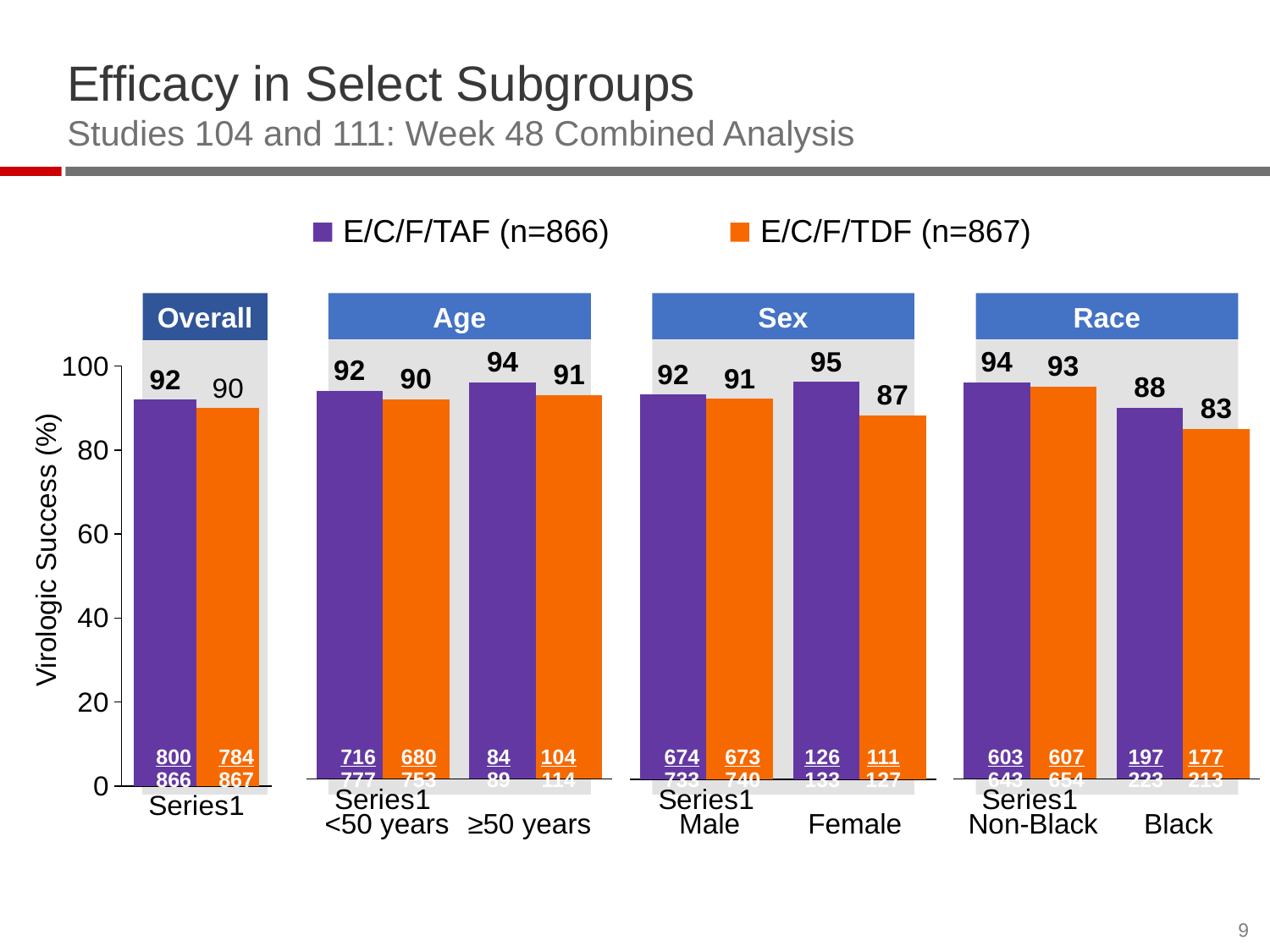
In the Overall chart, what is the virologic success value for E/C/F/TDF? 90 In the Race chart, what is the value for E/C/F/TDF in the Black group? 83 In the Age chart, which group has the higher E/C/F/TAF value, <50 years or ≥50 years? ≥50 years In the Race chart, what is the difference between the E/C/F/TAF and E/C/F/TDF values for the Black group? 5 In the Age chart, what is the value for E/C/F/TDF in the ≥50 years group? 91 In the Overall chart, what is the virologic success value for E/C/F/TAF? 92 What kind of chart is used on this slide? Bar chart In the Race chart, which group has the lowest E/C/F/TDF value? Black In the Sex chart, what is the value for E/C/F/TAF in the Female group? 95 How many series does the legend list? 2 In the Sex chart, what is the difference between the E/C/F/TAF and E/C/F/TDF values for the Female group? 8 What is the label of the y axis? Virologic Success (%)